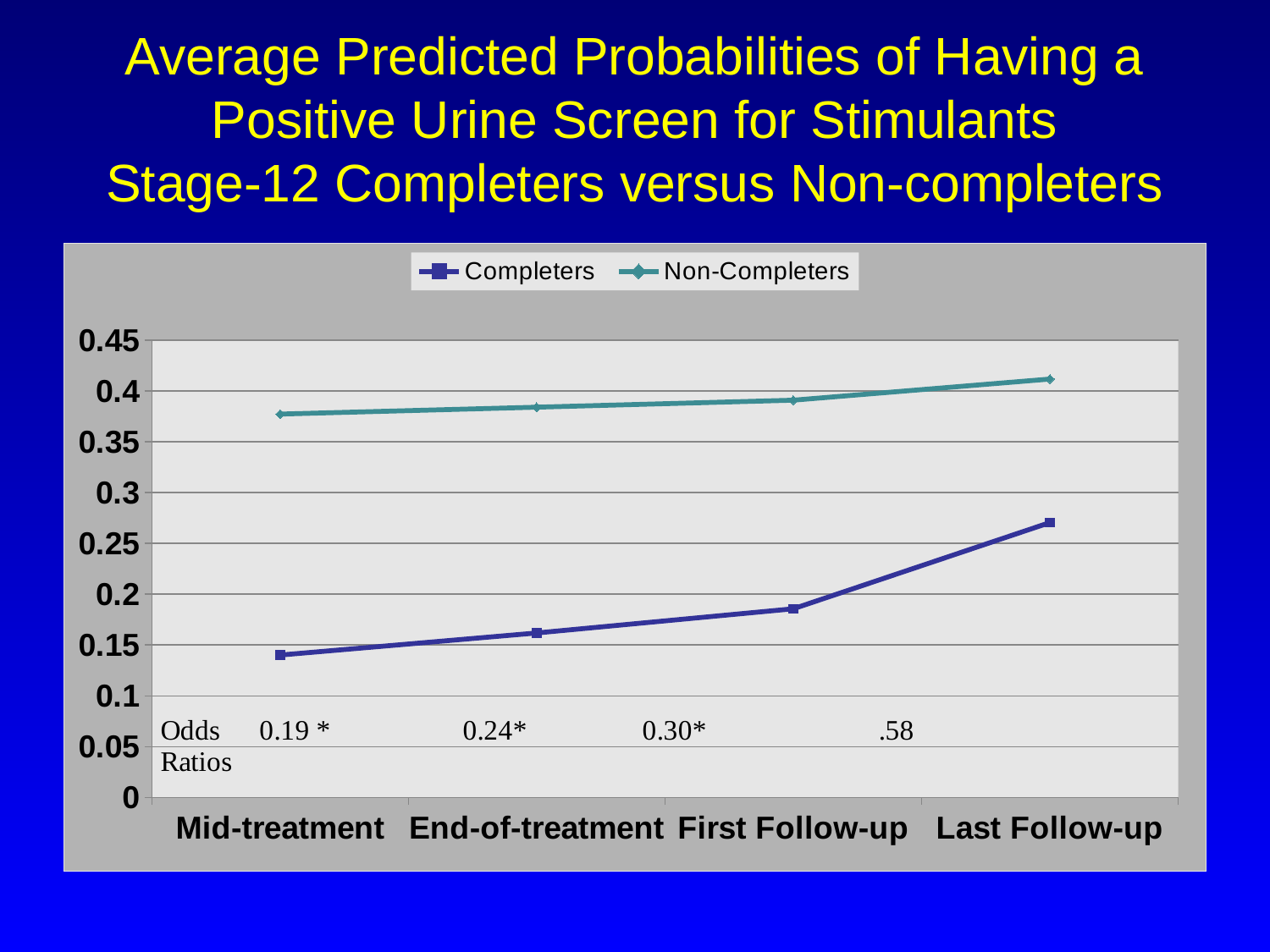
Is the Non-Completers value at Last Follow-up greater or less than 0.4? greater Which series is plotted with the higher line, Completers or Non-Completers? Non-Completers How many series does the legend list? 2 Is the Non-Completers value at Mid-treatment greater or less than 0.35? greater Is the Completers value at Last Follow-up greater or less than 0.25? greater How many time points are plotted along the x axis? 4 What kind of chart is shown on the slide? line chart At which time point is the Completers value lowest? Mid-treatment At which time point is the Completers value highest? Last Follow-up Do the Completers values rise or fall from Mid-treatment to Last Follow-up? rise What odds ratio is printed on the chart for Last Follow-up? .58